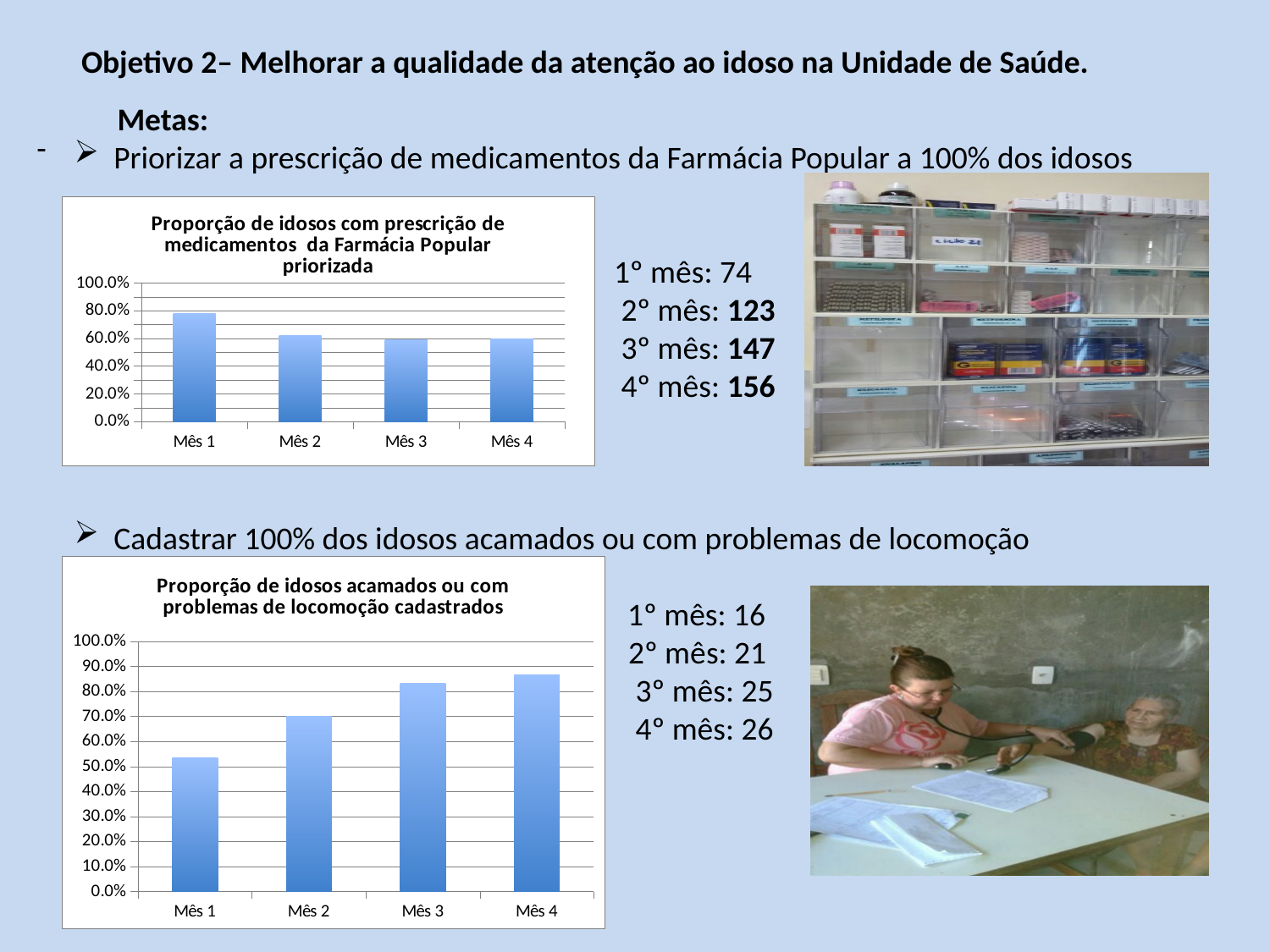
In the bottom chart, is the value for Mês 3 greater or less than 70.0%? greater In the top chart, which month has the highest proportion? Mês 1 In the bottom chart, which month has the lowest proportion? Mês 1 In the bottom chart, which is larger, the value for Mês 2 or the value for Mês 3? Mês 3 In the top chart, which is larger, the value for Mês 1 or the value for Mês 2? Mês 1 In the top chart, how many months (categories) are plotted? 4 In the bottom chart, do the values rise or fall from Mês 1 to Mês 4? rise In the top chart, is the value for Mês 1 greater or less than 60.0%? greater In the bottom chart, is the value for Mês 2 greater or less than 80.0%? less What kind of chart is the top chart, 'Proporção de idosos com prescrição de medicamentos da Farmácia Popular priorizada'? bar chart What kind of chart is the bottom chart, 'Proporção de idosos acamados ou com problemas de locomoção cadastrados'? bar chart